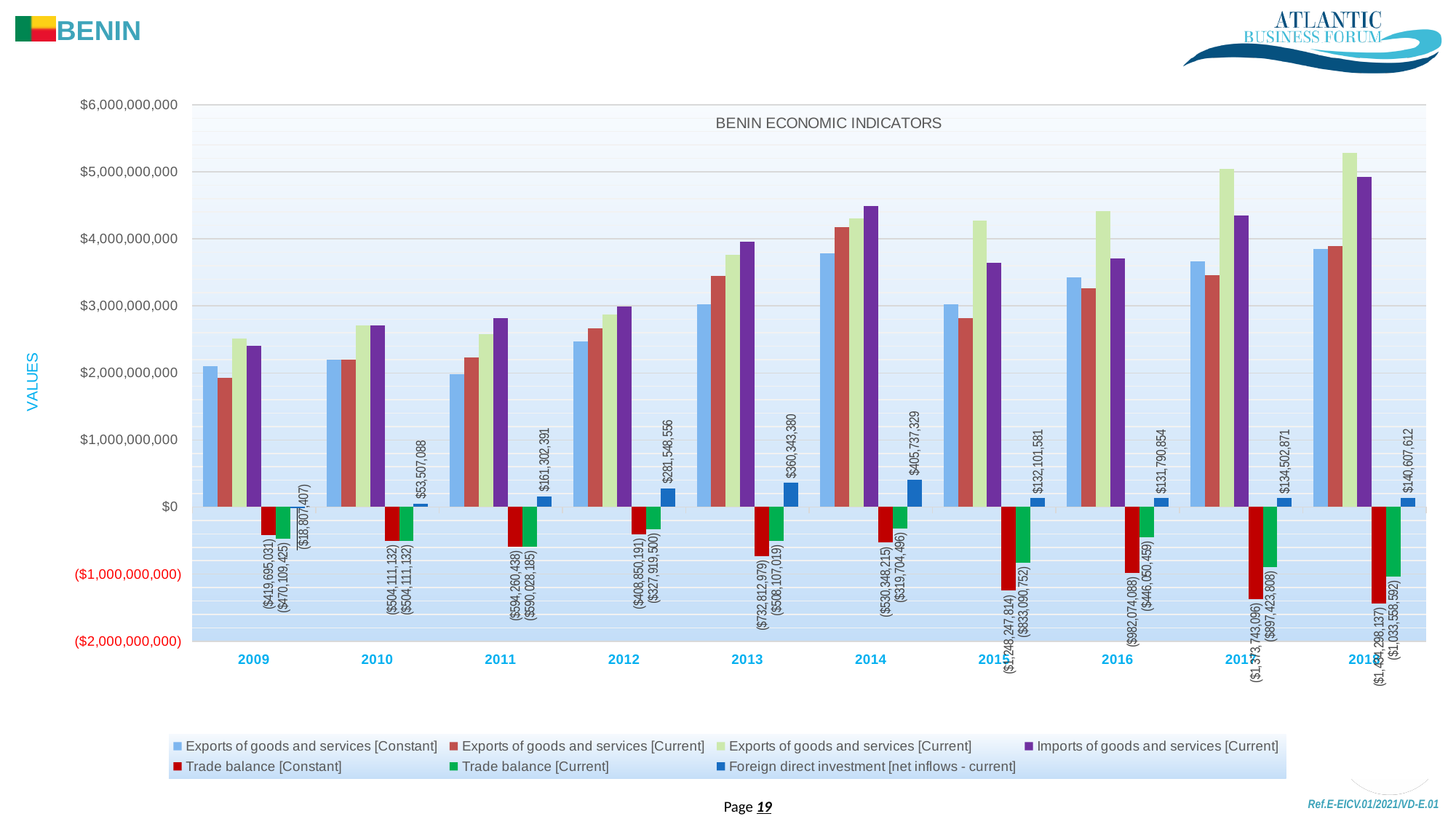
How many series does the legend list? 7 In which year is Foreign direct investment [net inflows - current] lowest? 2009 What is the difference between Foreign direct investment [net inflows - current] in 2014 and in 2013? $45,393,949 How many years are shown on the x axis? 10 In which year is Foreign direct investment [net inflows - current] highest? 2014 What is the value of Foreign direct investment [net inflows - current] for 2013? $360,343,380 What is the value of Trade balance [Current] for 2018? ($1,033,558,592) What is the title of the chart? BENIN ECONOMIC INDICATORS Which is larger: Foreign direct investment [net inflows - current] in 2012 or in 2016? 2012 What is the value of Trade balance [Constant] for 2015? ($1,248,247,814) Is the value of Imports of goods and services [Current] for 2018 greater or less than $4,000,000,000? greater What kind of chart is shown on the slide? bar chart